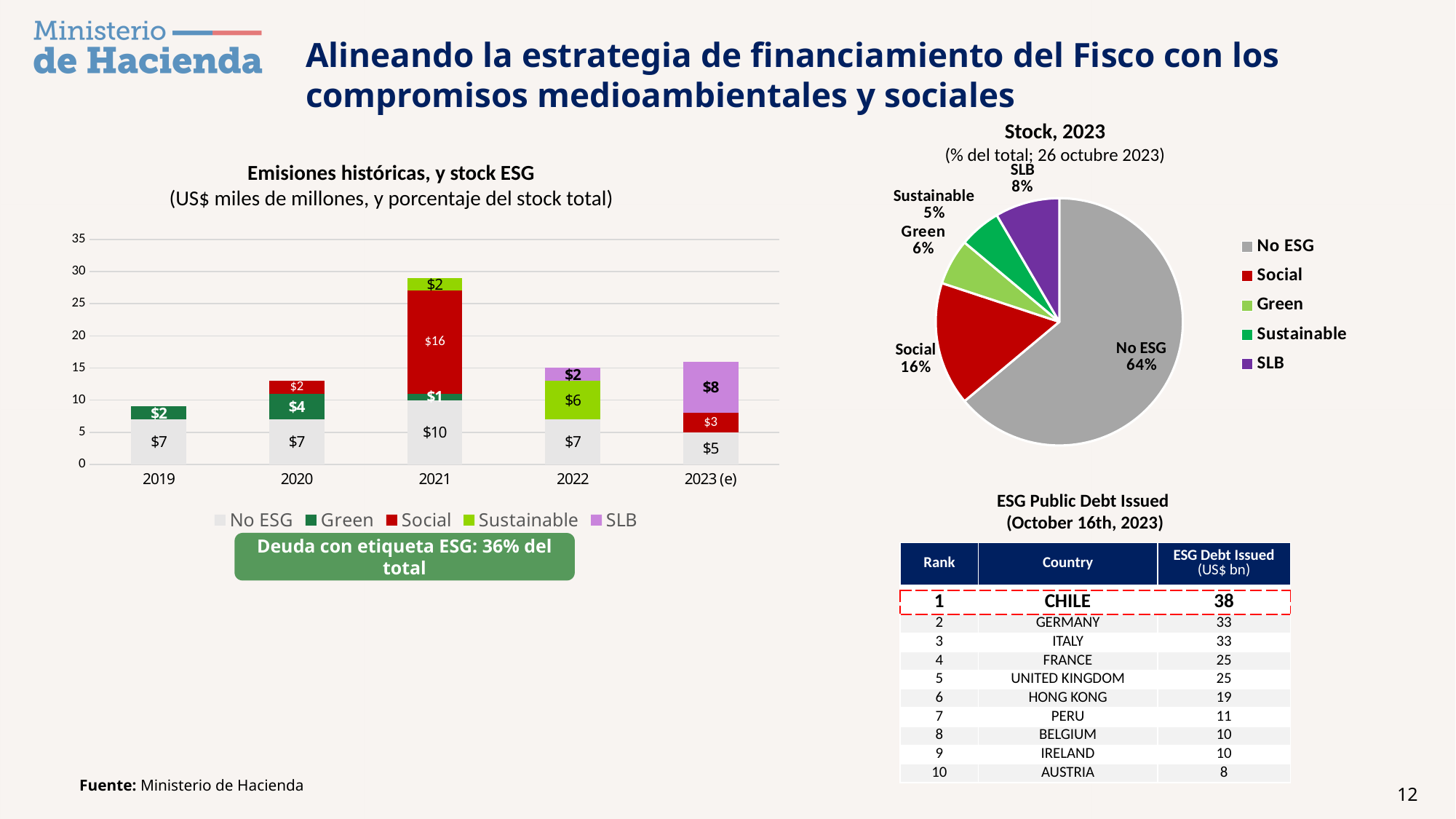
In the bar chart 'Emisiones históricas, y stock ESG', which year has the tallest stacked bar? 2021 What kind of chart is 'Emisiones históricas, y stock ESG'? Stacked bar chart In the bar chart 'Emisiones históricas, y stock ESG', how many series does the legend list? 5 In the pie chart 'Stock, 2023', which category has the smallest slice? Sustainable In the bar chart 'Emisiones históricas, y stock ESG', what is the difference between the Social value in 2021 and the Social value in 2023 (e)? $13 In the bar chart 'Emisiones históricas, y stock ESG', what is the Social value for 2021? $16 In the pie chart 'Stock, 2023', what share of the total is No ESG? 64% In the bar chart 'Emisiones históricas, y stock ESG', what is the total of the stacked bar for 2019? $9 In the bar chart 'Emisiones históricas, y stock ESG', what is the total of the stacked bar for 2021? $29 In the bar chart 'Emisiones históricas, y stock ESG', what is the SLB value for 2023 (e)? $8 In the bar chart 'Emisiones históricas, y stock ESG', how many years are shown on the x axis? 5 In the bar chart 'Emisiones históricas, y stock ESG', what is the No ESG value for 2021? $10